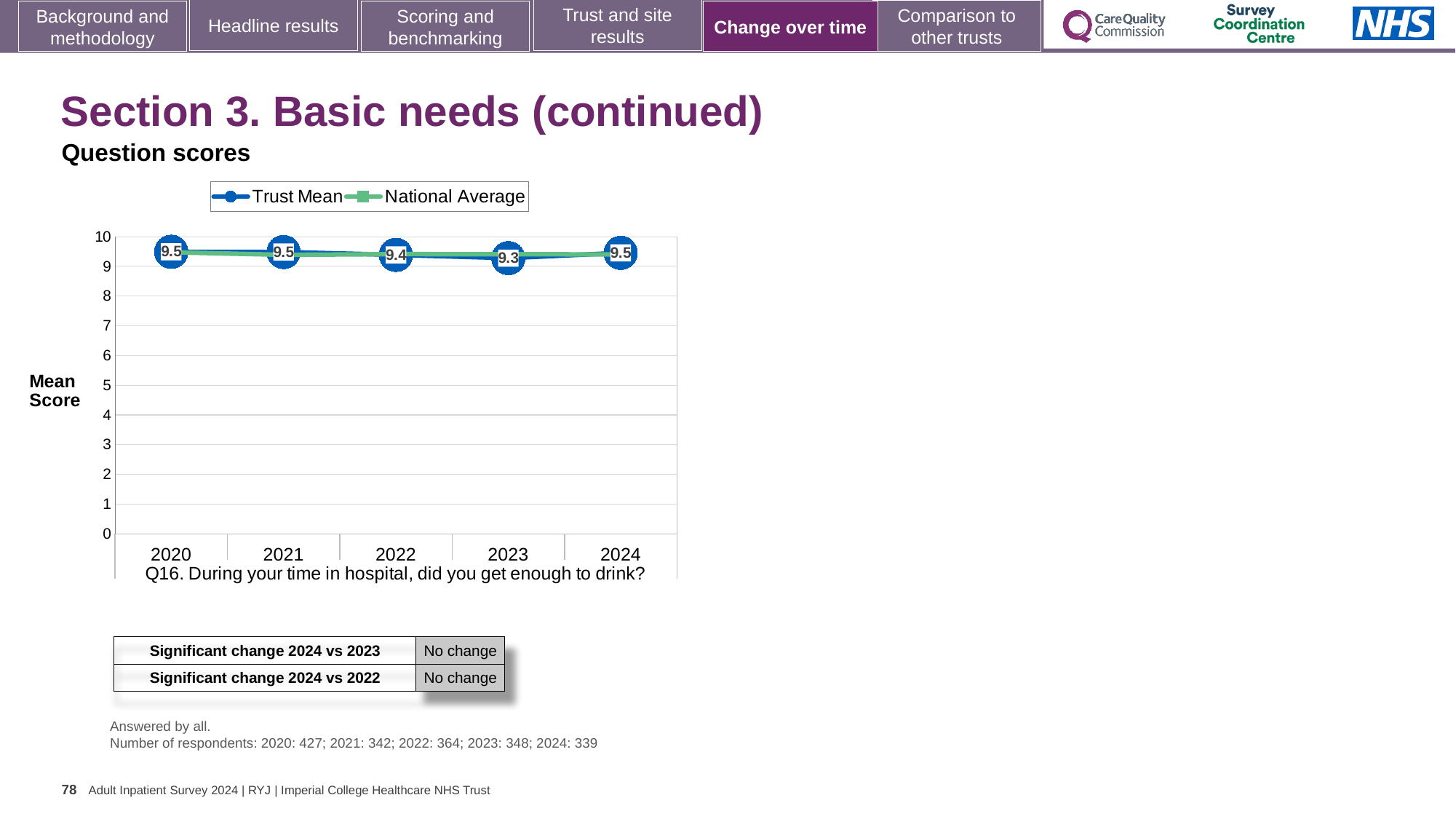
What kind of chart is shown on the slide? Line chart What is the Trust Mean score for 2024? 9.5 How many series does the legend list? 2 How many years are plotted on the x axis? 5 What is the Trust Mean score for 2022? 9.4 What is the Trust Mean score for 2020? 9.5 In which year is the Trust Mean score lowest? 2023 What is the Trust Mean score for 2023? 9.3 Which year has the higher Trust Mean score, 2022 or 2023? 2022 Is the National Average value for 2024 greater or less than 8? greater What is the difference between the Trust Mean score in 2024 and in 2023? 0.2 Does the Trust Mean score rise or fall from 2023 to 2024? Rise